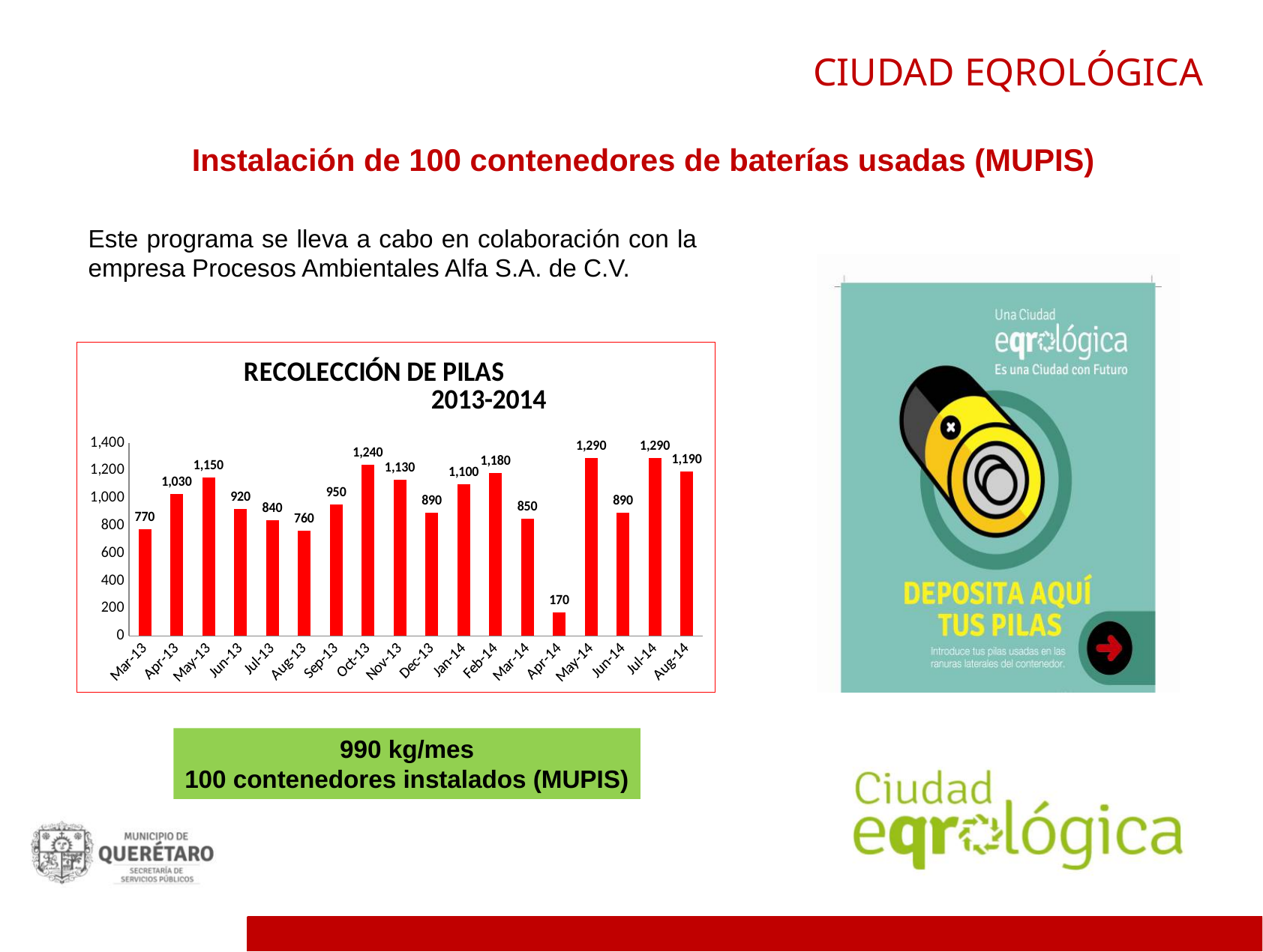
What type of chart is shown on the slide? bar chart What is the difference between the values for May-13 and Jun-13? 230 Which month has the lowest value? Apr-14 What is the value for Mar-13? 770 How many months are plotted in the chart? 18 What is the value for Oct-13? 1,240 What colour are the bars in the chart? red Which is larger, the value for Nov-13 or the value for Jan-14? Nov-13 What is the difference between the values for Feb-14 and Mar-14? 330 What is the value for Apr-14? 170 What is the highest value shown in the chart? 1,290 What is the title of the chart? RECOLECCIÓN DE PILAS 2013-2014